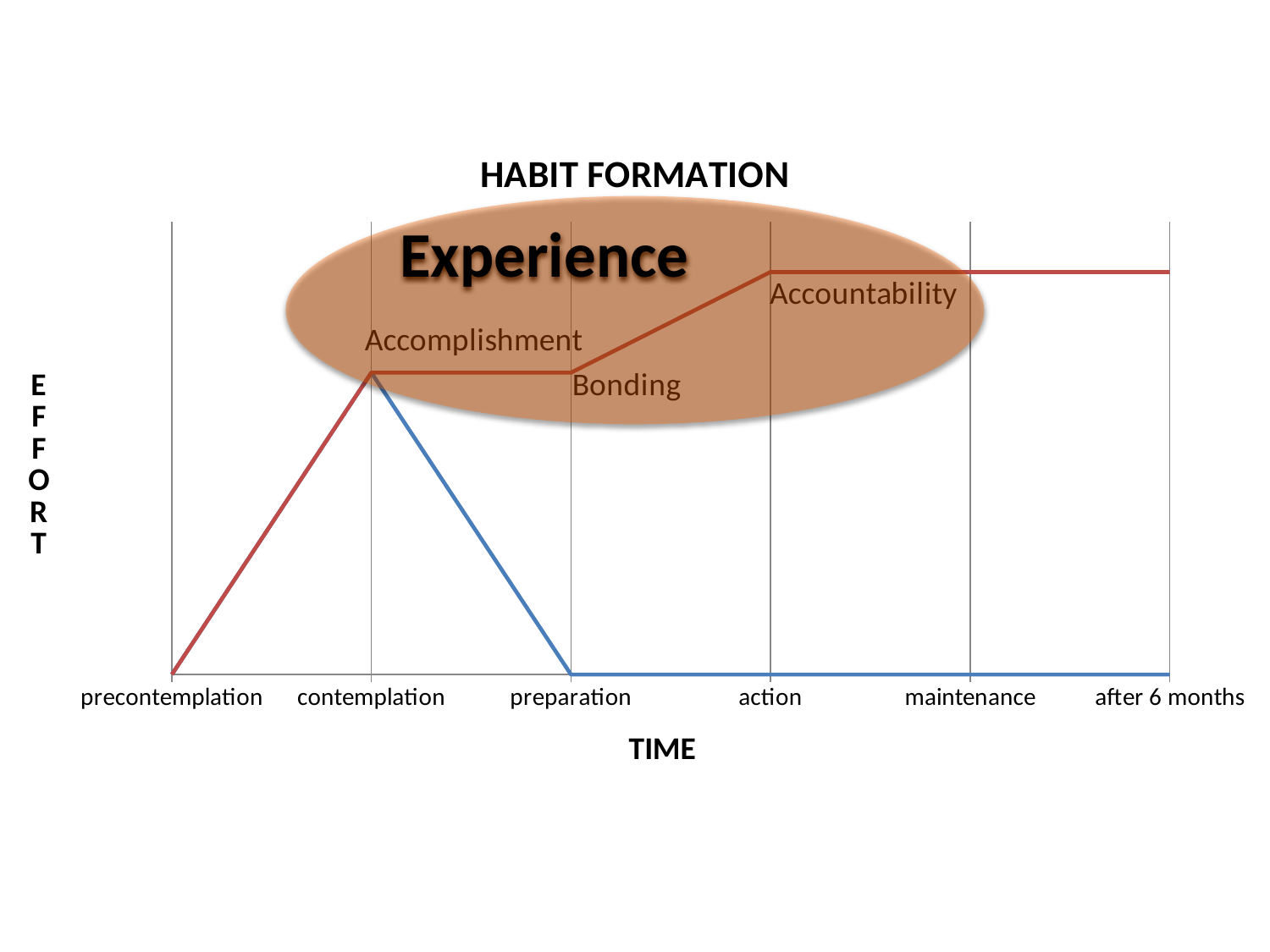
What is the title of the chart? HABIT FORMATION At which x-axis category is the red line at its lowest? precontemplation Does the blue line rise or fall between contemplation and preparation? fall How many categories are shown along the x axis of the chart? 6 What is the label on the vertical axis of the chart? EFFORT Does the red line rise or fall between preparation and action? rise At preparation, which line is higher, the red line or the blue line? red line Does the red line rise or fall between precontemplation and contemplation? rise What kind of chart is shown on the slide? line chart At which x-axis category is the blue line at its highest? contemplation Which x-axis category comes immediately after action? maintenance At after 6 months, which line is higher, the red line or the blue line? red line